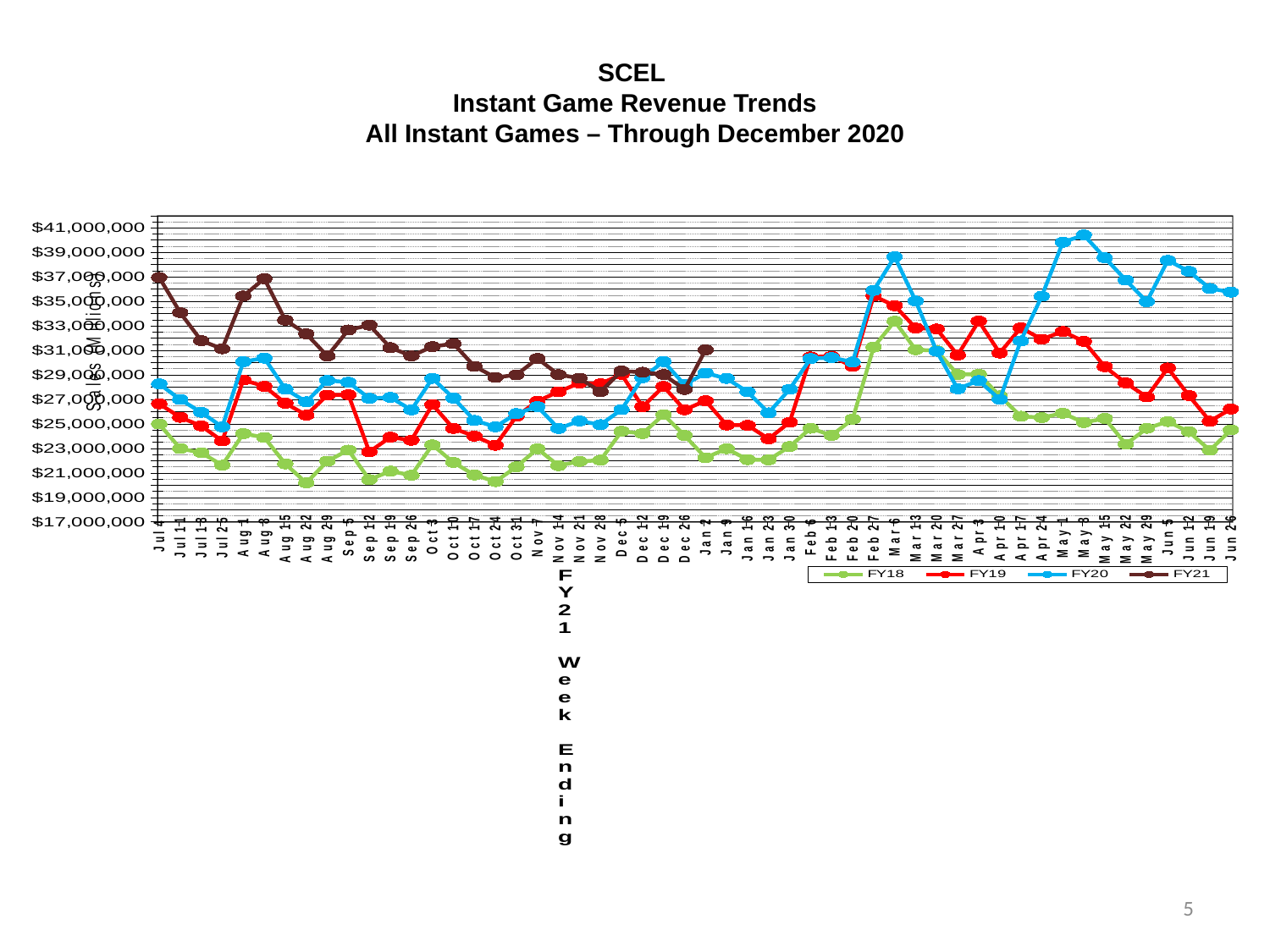
Is the FY19 value for the week ending Sep 12 greater or less than $25,000,000? less Is the FY18 value for the week ending Aug 22 greater or less than $21,000,000? less How many series does the legend list? 4 Which is larger at the week ending Jul 4, the FY21 value or the FY18 value? FY21 Is the FY20 value for the week ending May 8 greater or less than $39,000,000? greater Which series has the highest value at the week ending May 8? FY20 Which series has the lowest value at the week ending Jul 4? FY18 What kind of chart is shown on the slide? Line chart Does the FY21 series rise or fall from the week ending Jul 4 to the week ending Jul 25? Fall Which colour is used for the FY20 series? Blue Which series has the highest value at the week ending Jul 4? FY21 What is the title of the chart? SCEL Instant Game Revenue Trends All Instant Games – Through December 2020